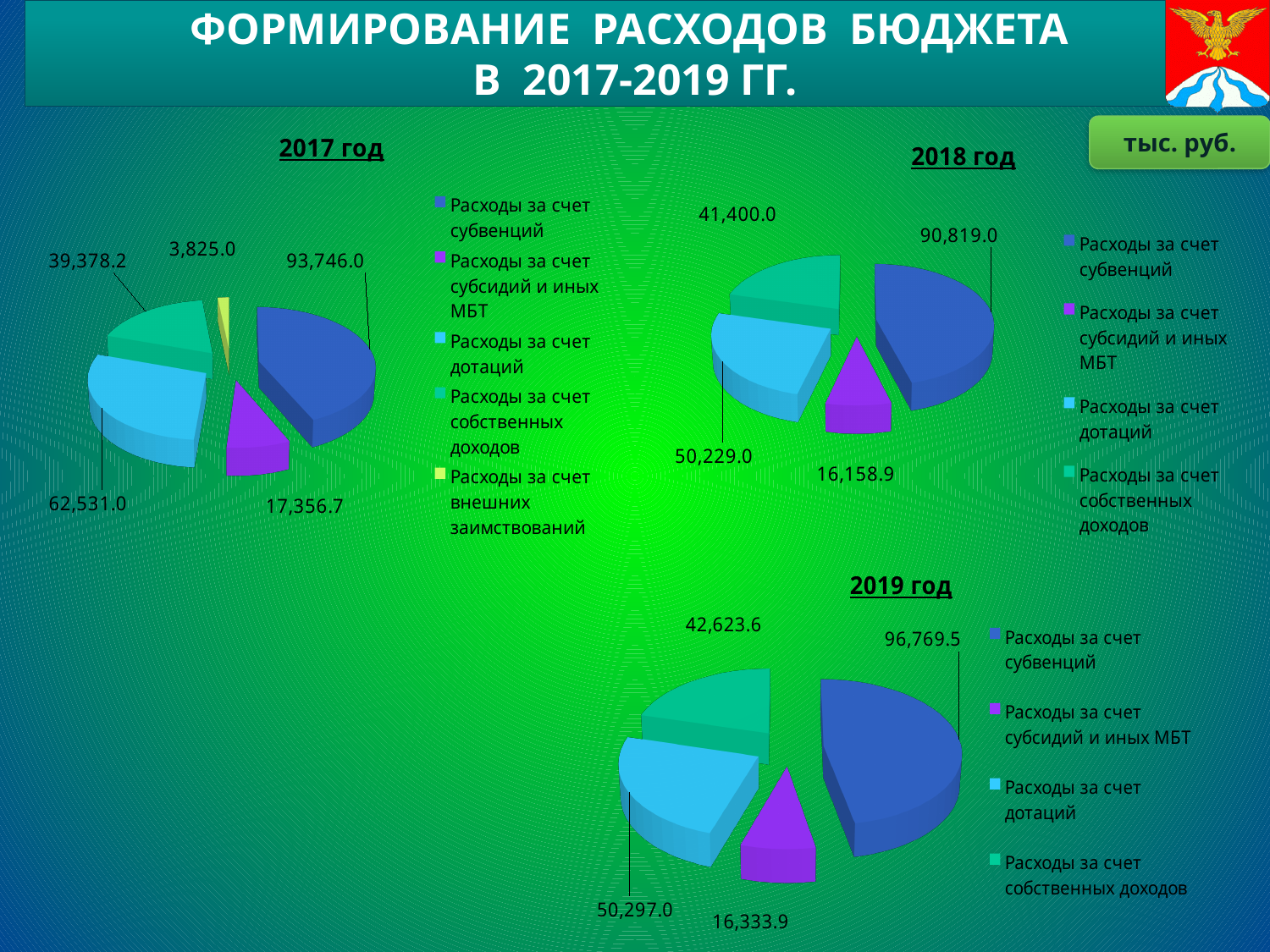
In the 2017 год chart, what is the value for Расходы за счет субвенций? 93,746.0 How many slices does the 2017 год chart have? 5 In the 2019 год chart, what is the value for Расходы за счет собственных доходов? 42,623.6 In the 2018 год chart, what is the value for Расходы за счет дотаций? 50,229.0 In the 2017 год chart, what is the difference between Расходы за счет субвенций and Расходы за счет дотаций? 31,215.0 What type of chart is the 2019 год chart? Pie chart In the 2017 год chart, what is the value for Расходы за счет внешних заимствований? 3,825.0 In the 2019 год chart, what is the value for Расходы за счет субсидий и иных МБТ? 16,333.9 In the 2019 год chart, which category has the largest value? Расходы за счет субвенций In the 2018 год chart, which is larger: Расходы за счет дотаций or Расходы за счет собственных доходов? Расходы за счет дотаций In the 2017 год chart, which category has the smallest value? Расходы за счет внешних заимствований How many entries does the legend of the 2018 год chart list? 4